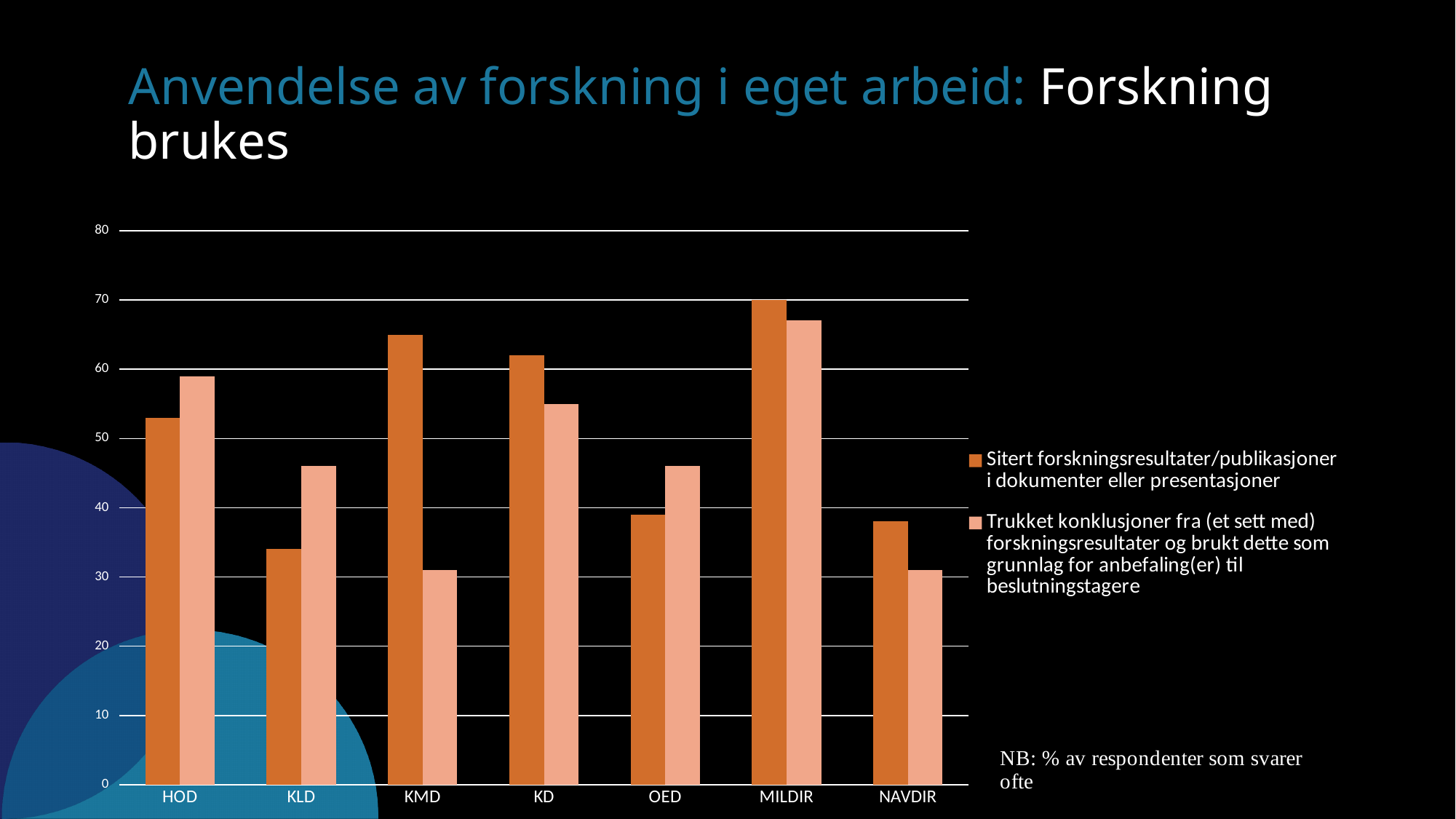
Is the value for KLD in the series 'Trukket konklusjoner fra (et sett med) forskningsresultater...' greater or less than 40? greater Which category has the highest value for the series 'Trukket konklusjoner fra (et sett med) forskningsresultater og brukt dette som grunnlag for anbefaling(er) til beslutningstagere'? MILDIR How many categories are shown on the x axis of the chart? 7 For KMD, which series has the larger value: 'Sitert forskningsresultater/publikasjoner i dokumenter eller presentasjoner' or 'Trukket konklusjoner fra (et sett med) forskningsresultater...'? Sitert forskningsresultater/publikasjoner i dokumenter eller presentasjoner For HOD, which series has the larger value: 'Sitert forskningsresultater/publikasjoner i dokumenter eller presentasjoner' or 'Trukket konklusjoner fra (et sett med) forskningsresultater...'? Trukket konklusjoner fra (et sett med) forskningsresultater og brukt dette som grunnlag for anbefaling(er) til beslutningstagere Which category has the highest value for the series 'Sitert forskningsresultater/publikasjoner i dokumenter eller presentasjoner'? MILDIR Is the value for KMD in the series 'Sitert forskningsresultater/publikasjoner i dokumenter eller presentasjoner' greater or less than 60? greater How many series does the legend list? 2 What is the highest value shown on the y axis of the chart? 80 What kind of chart is shown on the slide? bar chart Is the value for KLD in the series 'Sitert forskningsresultater/publikasjoner i dokumenter eller presentasjoner' greater or less than 40? less According to the note on the slide, what do the values in the chart represent? % av respondenter som svarer ofte